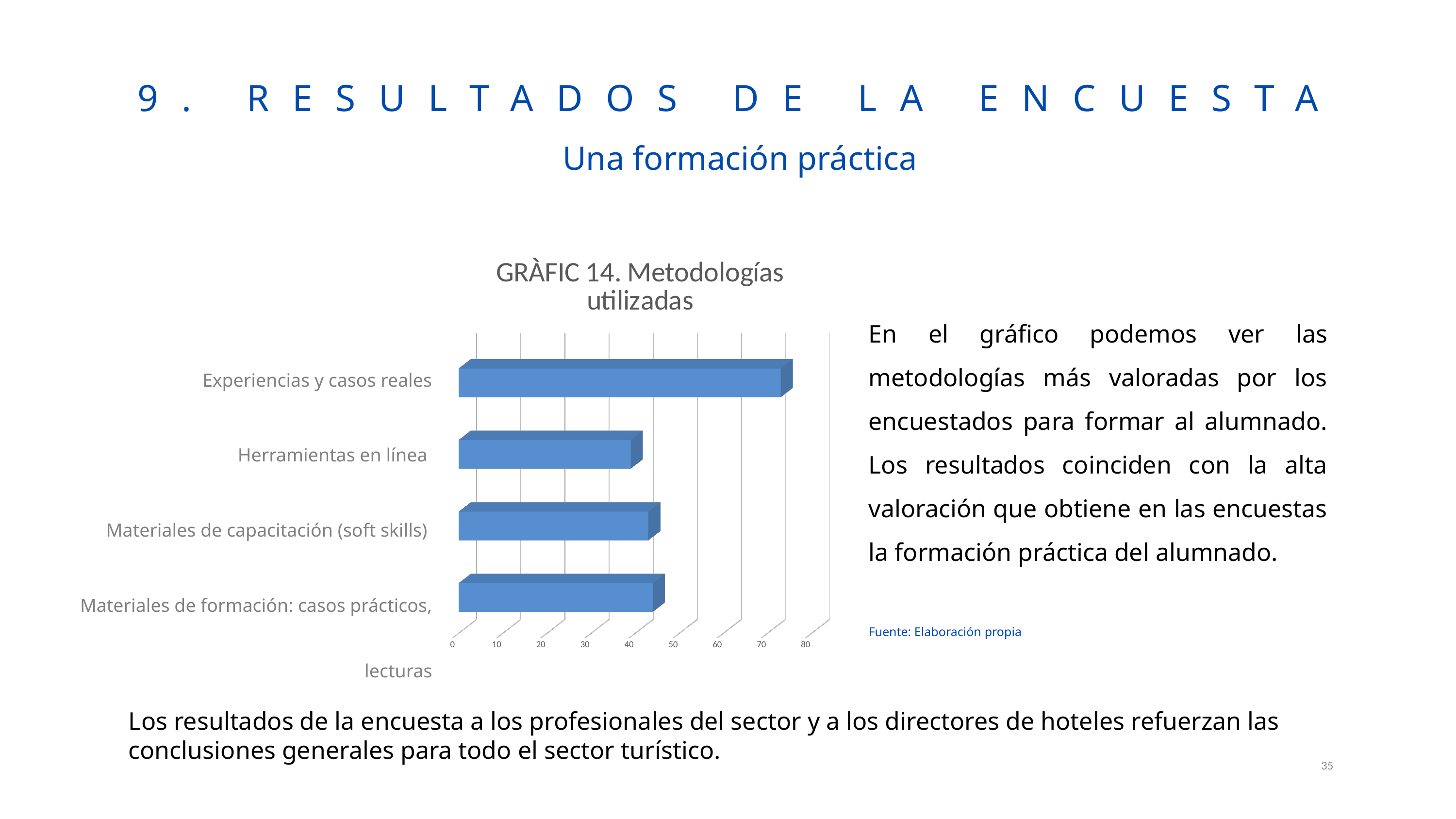
Is the value for Materiales de formación: casos prácticos, lecturas greater or less than 40? greater Is the value for Herramientas en línea greater or less than 50? less How many categories are plotted in the chart? 4 What is the title of the chart? GRÀFIC 14. Metodologías utilizadas Is the value for Experiencias y casos reales greater or less than 80? less Which category has the highest value in the chart? Experiencias y casos reales What source is cited below the chart? Fuente: Elaboración propia Which is larger, the value for Experiencias y casos reales or the value for Herramientas en línea? Experiencias y casos reales Which category has the lowest value in the chart? Herramientas en línea What kind of chart is shown on the slide? Bar chart